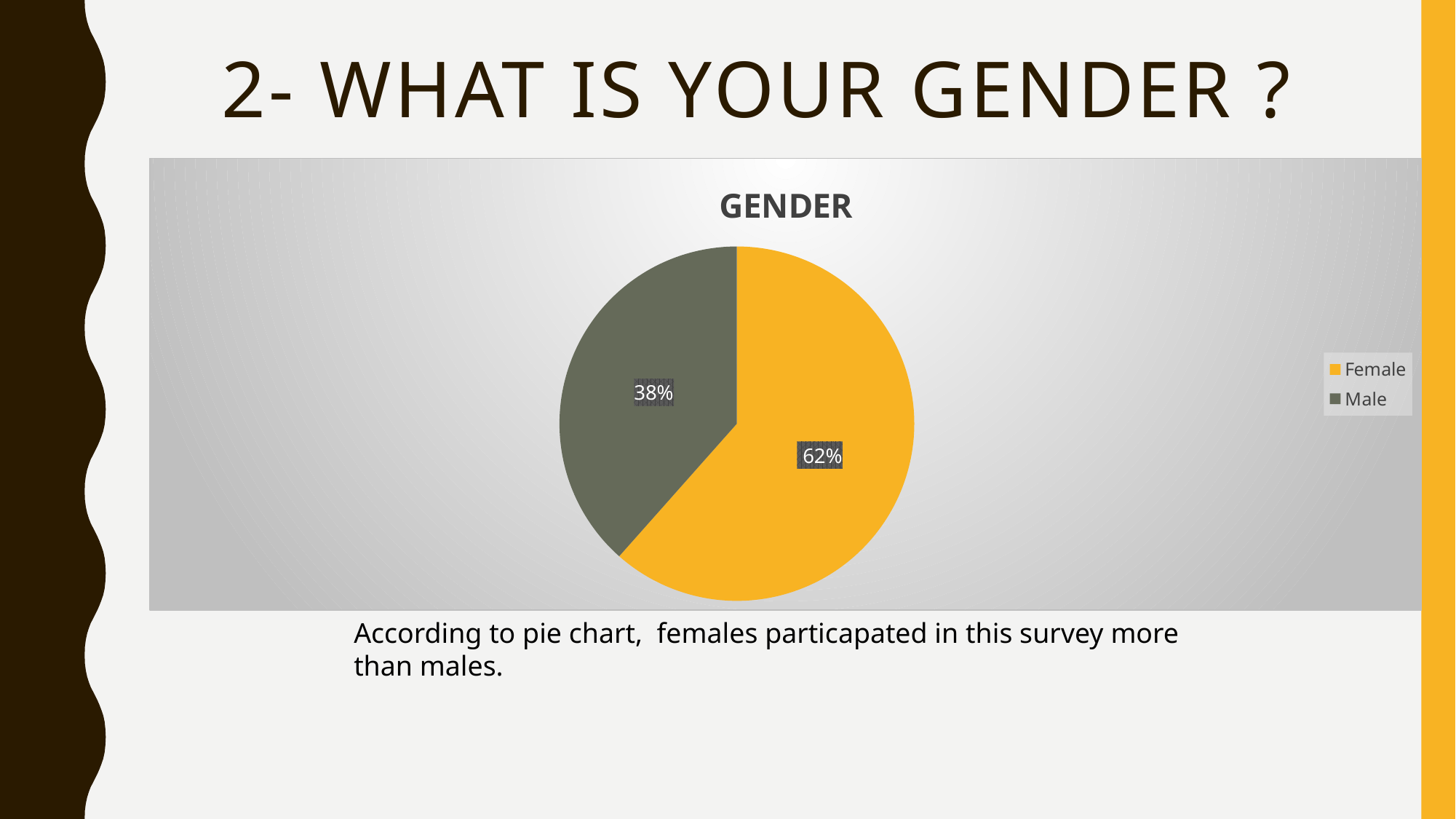
What colour is the Female slice in the pie chart? Yellow What share of the pie does the Male slice represent? 38% Which category has the largest share of the pie chart? Female Which category has the smallest share of the pie chart? Male What percentage of the pie chart is Male? 38% What is the difference in percentage points between the Female and Male slices? 24 What percentage of the pie chart is Female? 62% How many categories does the pie chart show? 2 What is the title of the chart? GENDER Which slice is larger, Female or Male? Female What kind of chart is shown on the slide? Pie chart